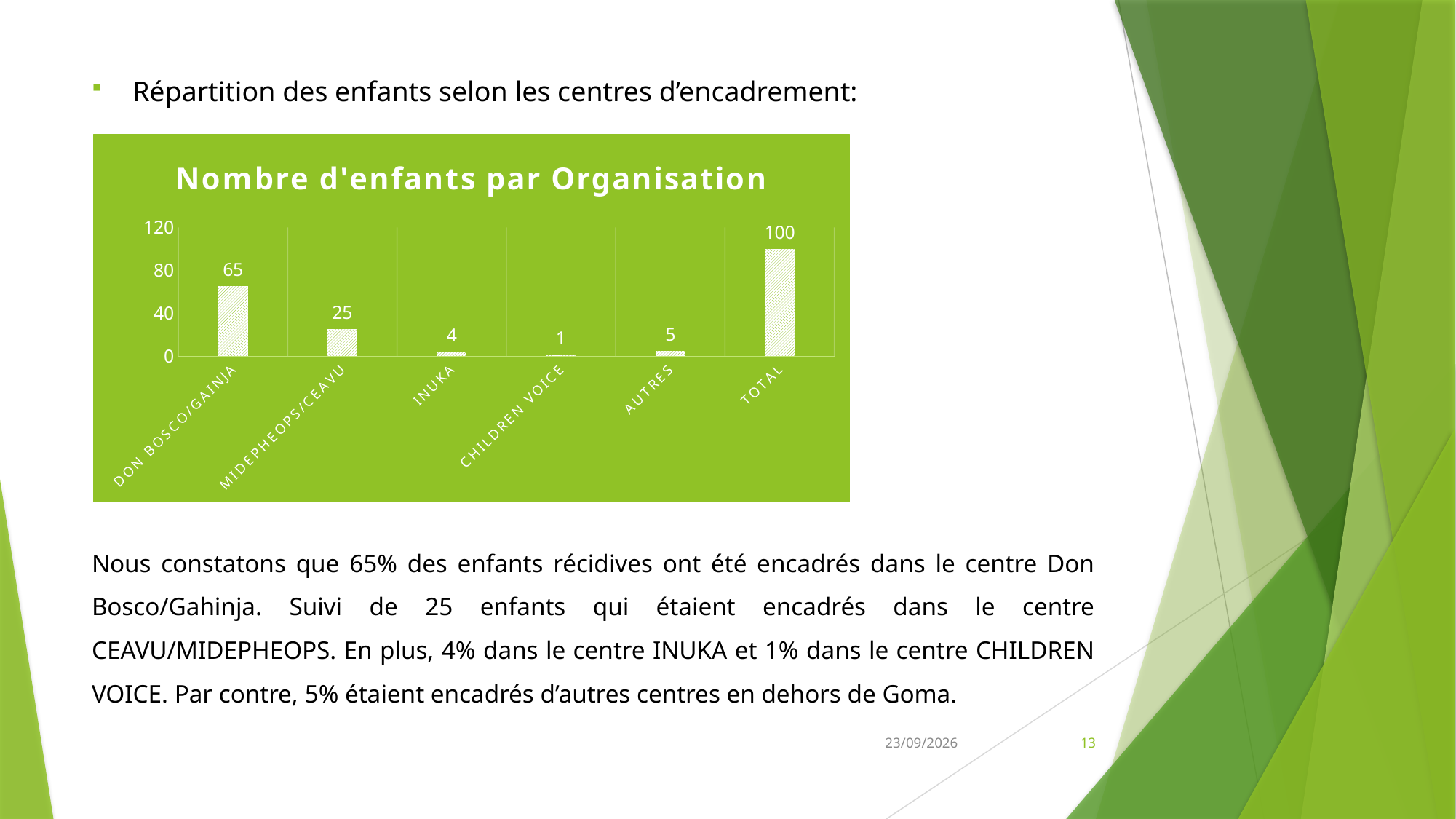
What is the value for AUTRES? 5 How many categories are shown on the x axis? 6 What is the value for CHILDREN VOICE? 1 What kind of chart is shown on the slide? Bar chart Which is larger, the value for AUTRES or the value for INUKA? AUTRES What is the value for INUKA? 4 What is the value for DON BOSCO/GAINJA? 65 What is the value for MIDEPHEOPS/CEAVU? 25 Which organisation has the lowest number of children? CHILDREN VOICE Excluding TOTAL, which organisation has the highest number of children? DON BOSCO/GAINJA What is the title of the chart? Nombre d'enfants par Organisation What is the difference between the values for DON BOSCO/GAINJA and MIDEPHEOPS/CEAVU? 40